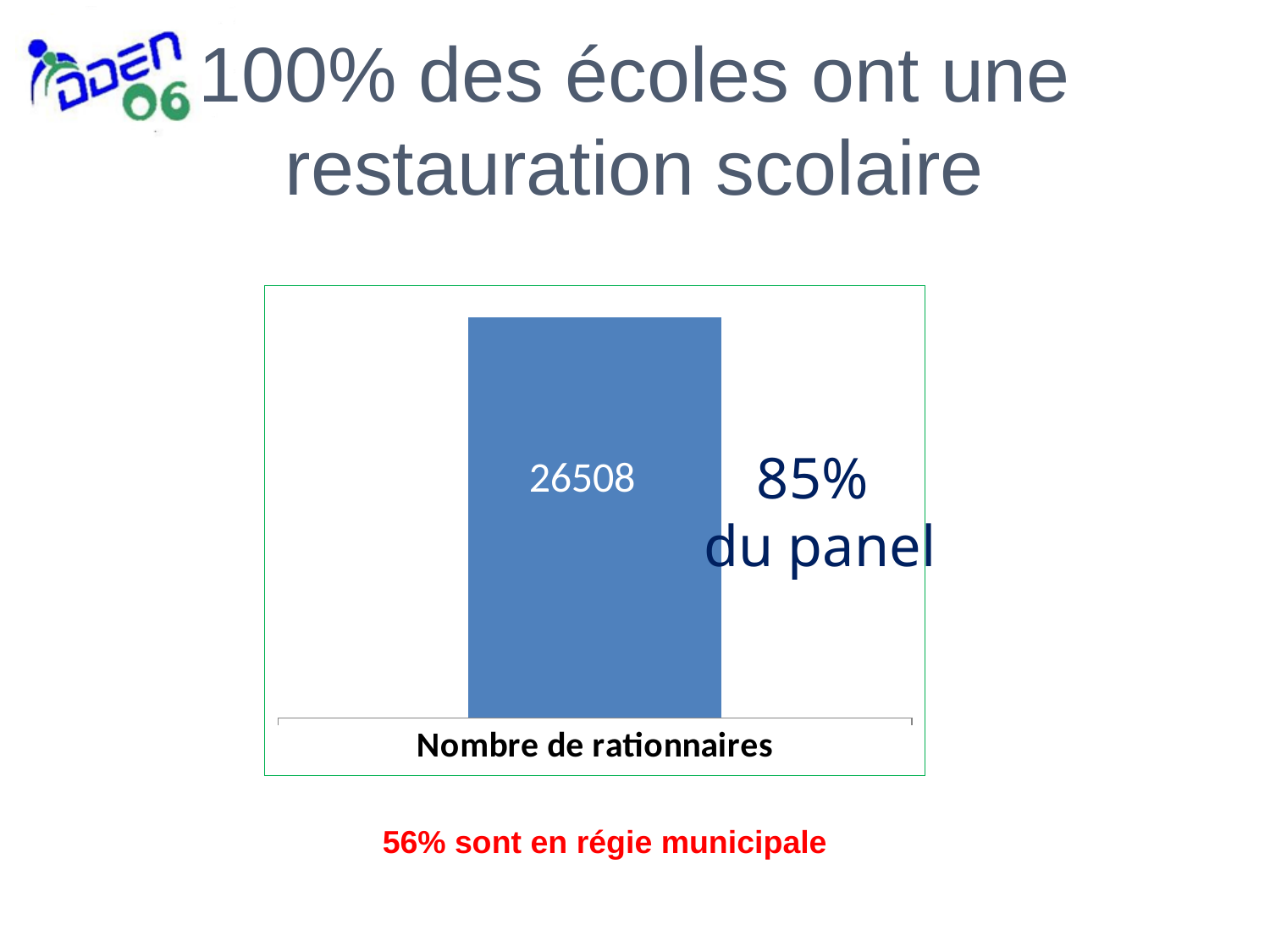
What percentage of the panel is indicated next to the bar in the chart? 85% What colour is the bar in the chart? blue What is the category label shown on the x axis of the chart? Nombre de rationnaires How many bars does the chart contain? 1 What is the value shown on the bar for "Nombre de rationnaires"? 26508 Is the value for "Nombre de rationnaires" greater or less than 20000? greater What kind of chart is shown on the slide? bar chart